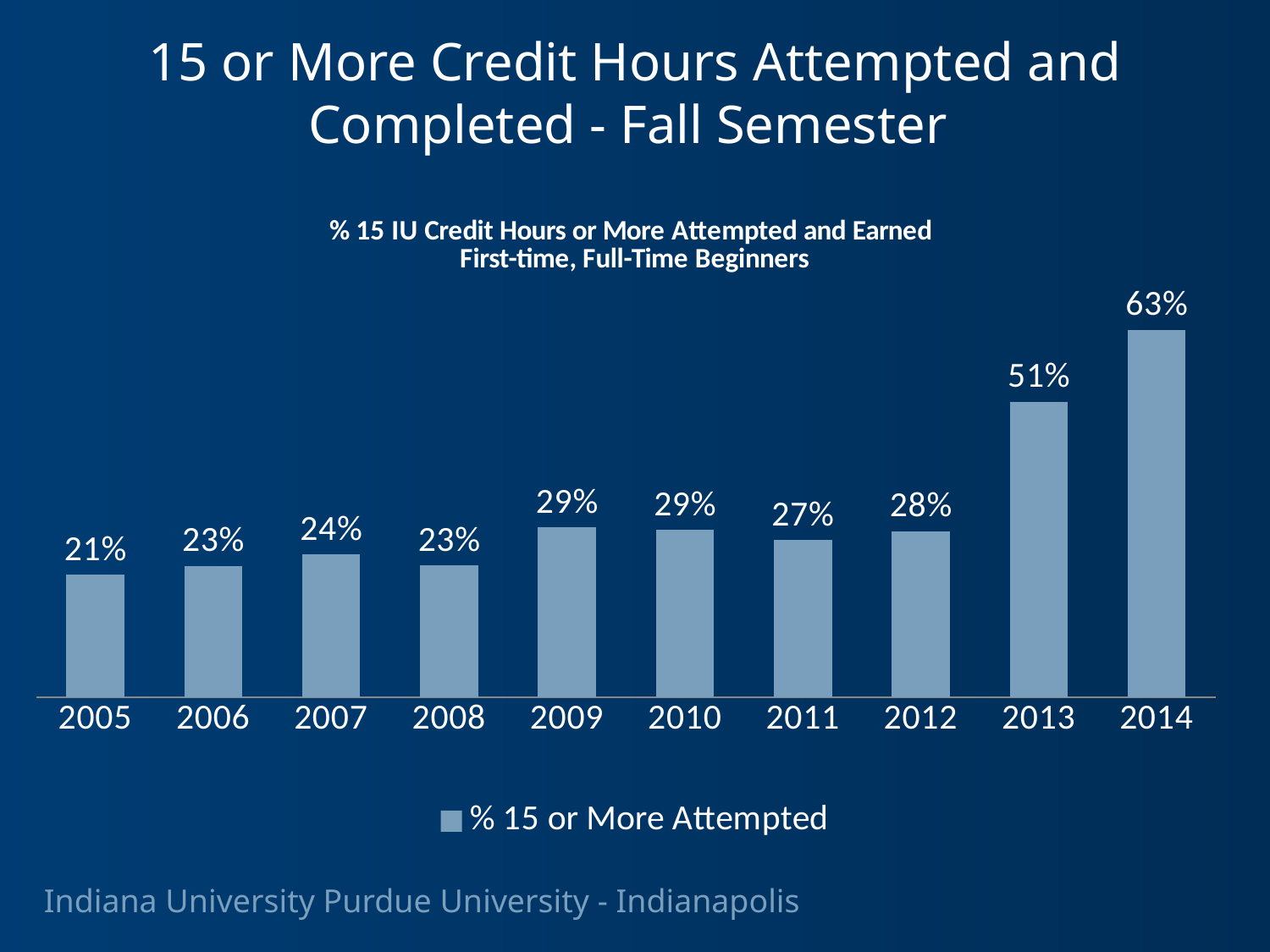
How many years are shown on the x axis? 10 Which year has the highest value? 2014 What is the legend entry for the series? % 15 or More Attempted How many series does the legend list? 1 What is the difference between the values for 2013 and 2005? 30% Which is larger, the value for 2009 or the value for 2008? 2009 What is the difference between the values for 2014 and 2013? 12% What kind of chart is shown? bar chart What is the value for 2014? 63% What is the value for 2011? 27% What is the value for 2005? 21% Which year has the lowest value? 2005